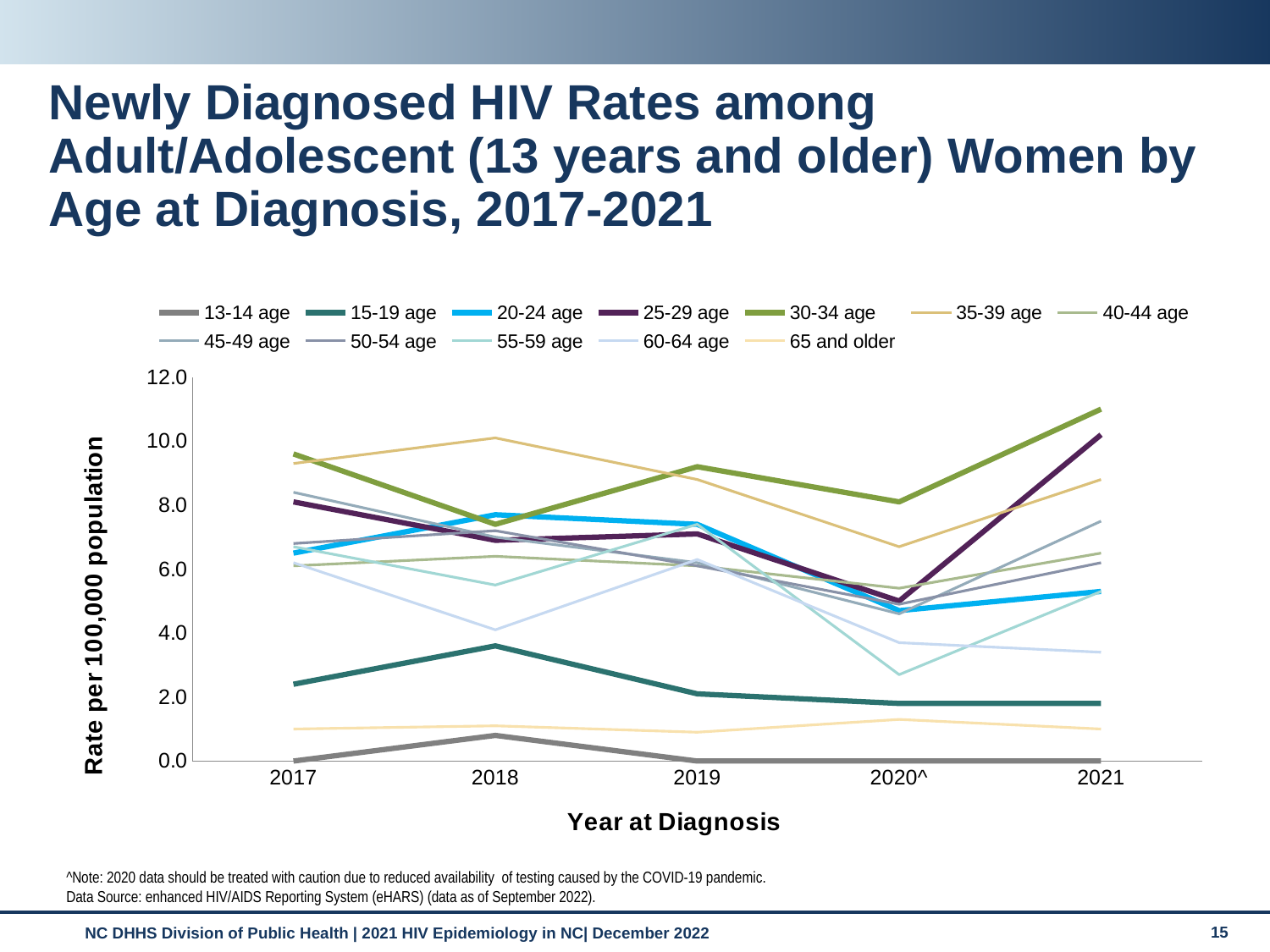
Which age group has the highest rate in 2021? 30-34 age Is the value for the 55-59 age group in 2020^ greater or less than 4.0? less In 2019, which is larger: the rate for the 30-34 age group or the 15-19 age group? 30-34 age Which age group has the lowest rate in 2017? 13-14 age How many years are plotted along the x axis? 5 Which age group has the highest rate in 2018? 35-39 age Is the value for the 15-19 age group in 2018 greater or less than 4.0? less How many series does the legend list? 12 What is the label on the y axis? Rate per 100,000 population What kind of chart is shown on the slide? Line chart Does the rate for the 15-19 age group rise or fall from 2018 to 2021? Fall Is the value for the 30-34 age group in 2021 greater or less than 10.0? greater